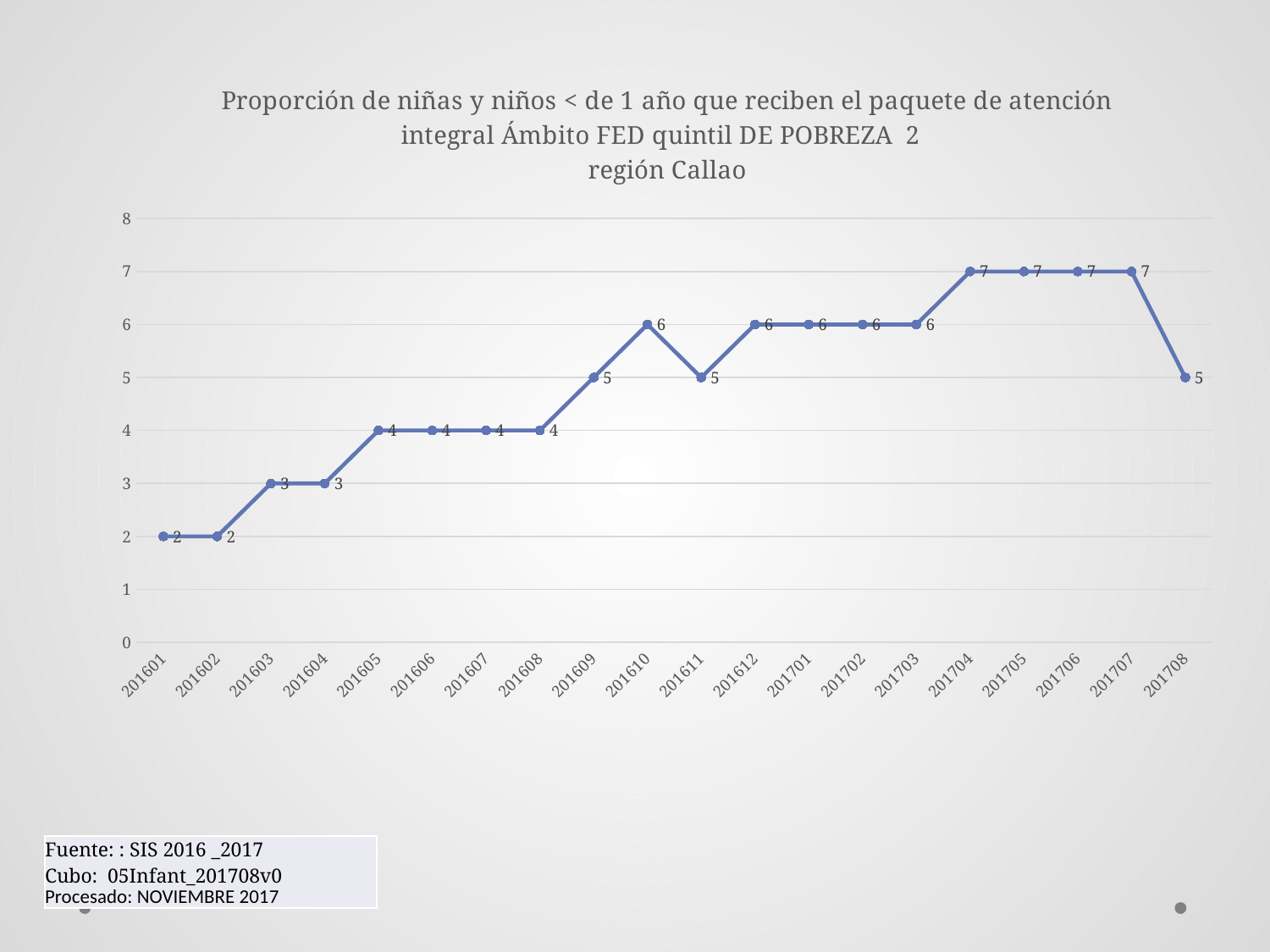
Which region does the chart title refer to? Callao What is the value for 201611? 5 What is the value for 201601? 2 Which period has the lowest value, 201601 or 201605? 201601 What is the highest value plotted on the chart? 7 How many data points are plotted on the chart? 20 What is the difference between the values for 201707 and 201708? 2 What kind of chart is shown on the slide? Line chart Do the values generally rise or fall from 201601 to 201707? Rise Which is larger, the value for 201610 or the value for 201611? 201610 What is the value for 201610? 6 What is the value for 201708? 5